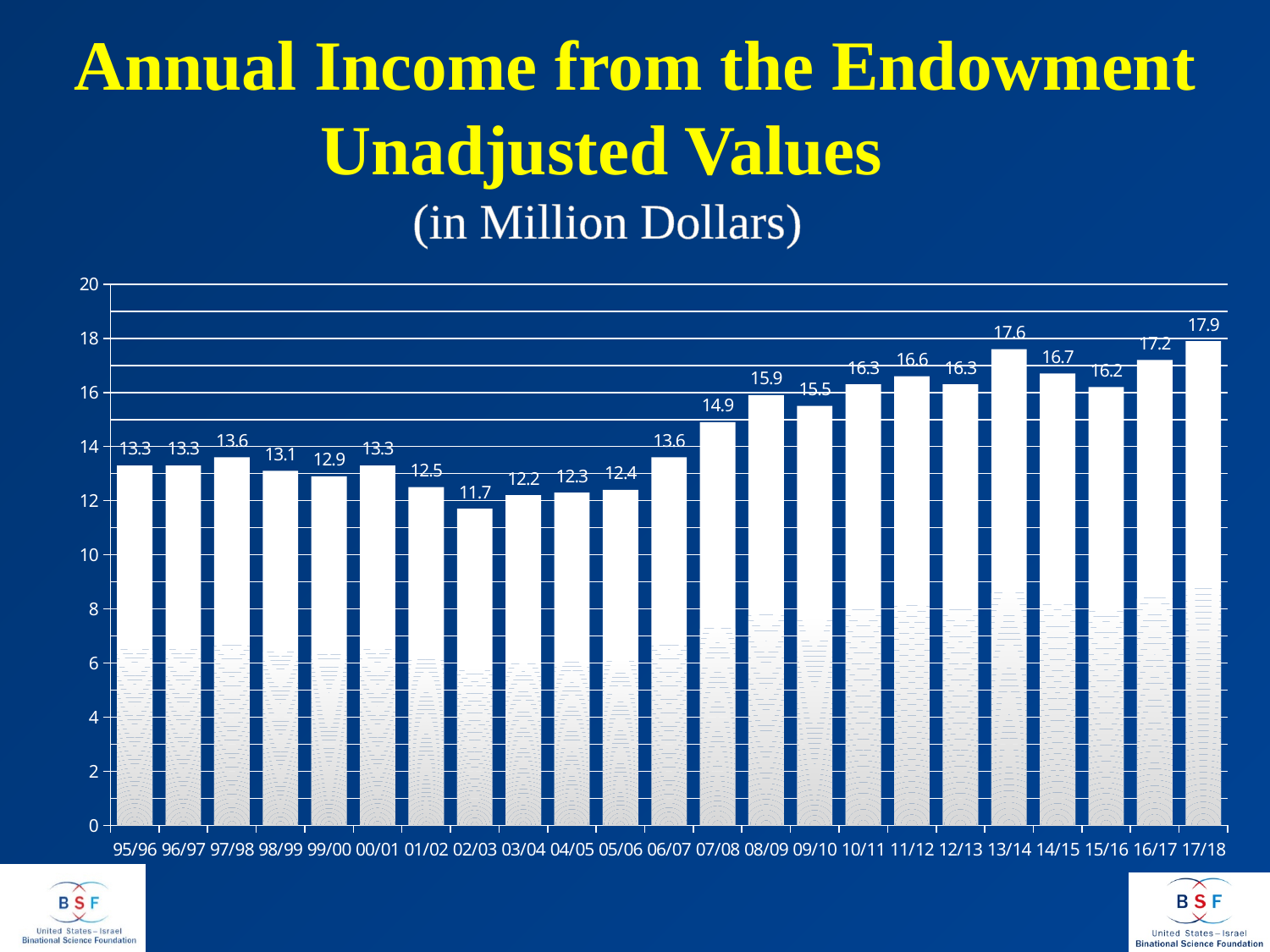
What is the annual income from the endowment for 17/18? 17.9 Which is larger, the value for 08/09 or the value for 09/10? 08/09 What is the difference between the values for 13/14 and 14/15? 0.9 What is the value shown for 13/14? 17.6 Which year has the highest annual income from the endowment? 17/18 In what unit are the values on the chart expressed, according to the title? Million Dollars Which year has the lowest annual income from the endowment? 02/03 What is the value shown for 07/08? 14.9 How many years are shown on the x axis? 23 What is the difference between the values for 17/18 and 02/03? 6.2 What kind of chart is shown on the slide? Bar chart What is the value shown for 02/03? 11.7